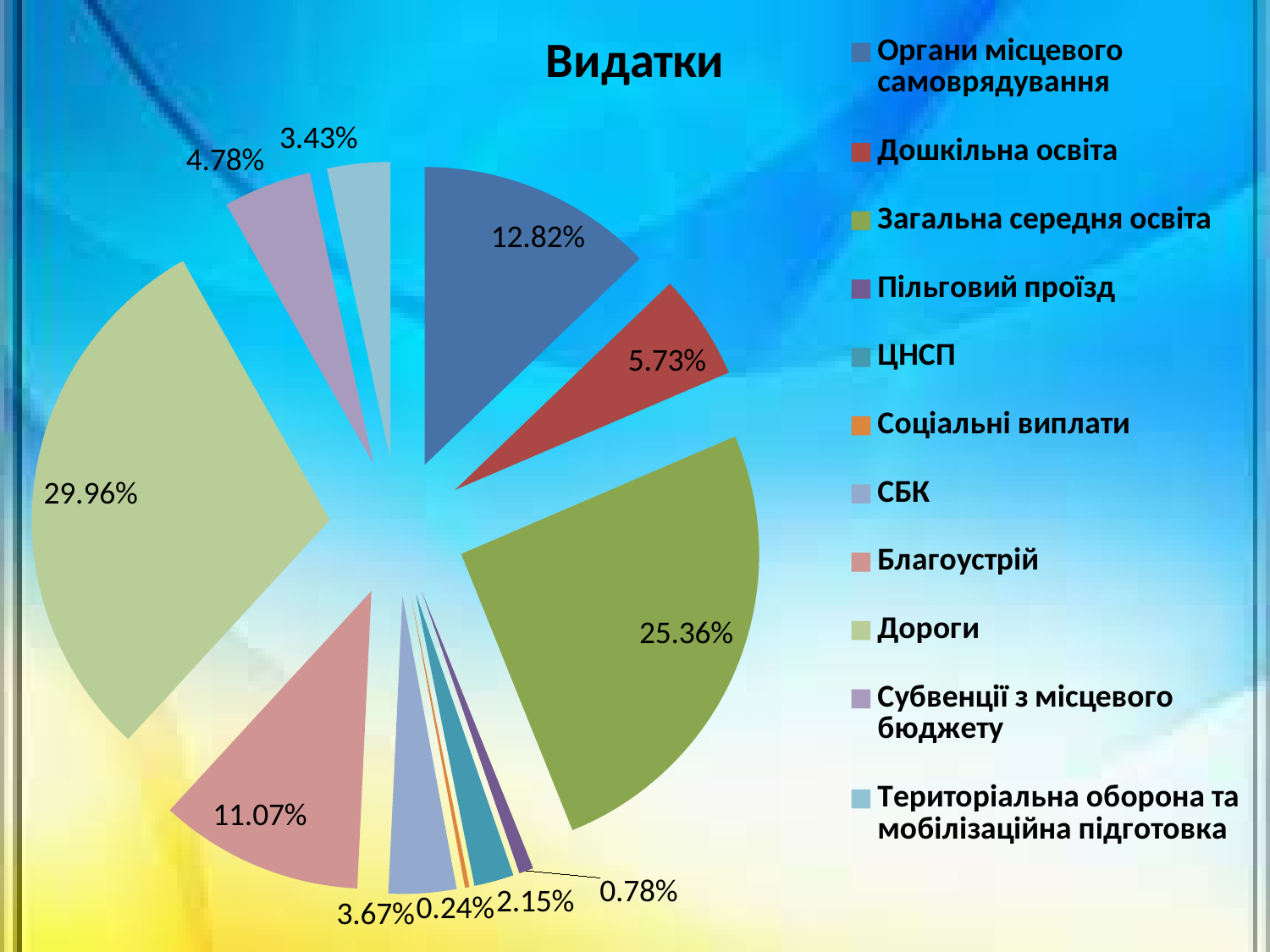
Which category has the largest slice of the pie? Дороги What is the value shown for Органи місцевого самоврядування? 12.82% Which is larger, the share for Дошкільна освіта or the share for Субвенції з місцевого бюджету? Дошкільна освіта What share of the pie does Дороги have? 29.96% What is the value shown for Територіальна оборона та мобілізаційна підготовка? 3.43% What is the difference between the shares of Дороги and Загальна середня освіта? 4.60% How many categories does the legend of the pie chart list? 11 Which category has the smallest slice of the pie? Соціальні виплати What share of the pie does Загальна середня освіта have? 25.36% What is the value shown for Благоустрій? 11.07% What kind of chart is shown on the slide? pie chart What is the title of the chart? Видатки